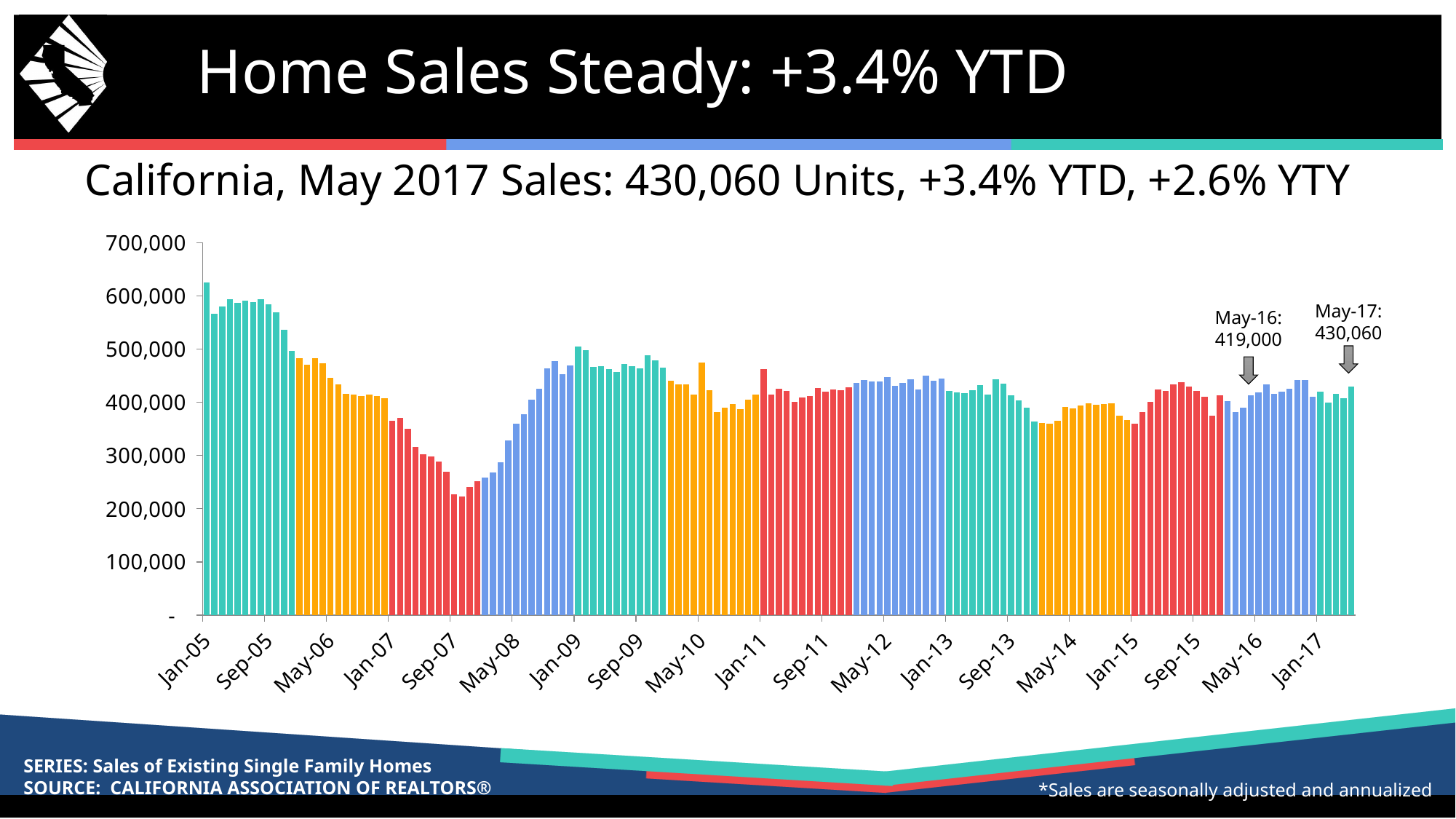
What is the value shown for May-16? 419,000 Do the values rise or fall between Jan-05 and Sep-07? Fall What kind of chart is shown on the slide? Bar chart Which month has the highest value on the chart? Jan-05 What is the difference between the May-17 value and the May-16 value? 11,060 Is the value for Jan-05 greater or less than 600,000? greater Is the lowest value on the chart greater or less than 300,000? less Which is larger, the value for May-16 or the value for May-17? May-17 Do the values rise or fall between Sep-07 and Jan-09? Rise What is the value shown for May-17? 430,060 What is the highest tick value shown on the vertical axis? 700,000 What is the title of the chart? California, May 2017 Sales: 430,060 Units, +3.4% YTD, +2.6% YTY